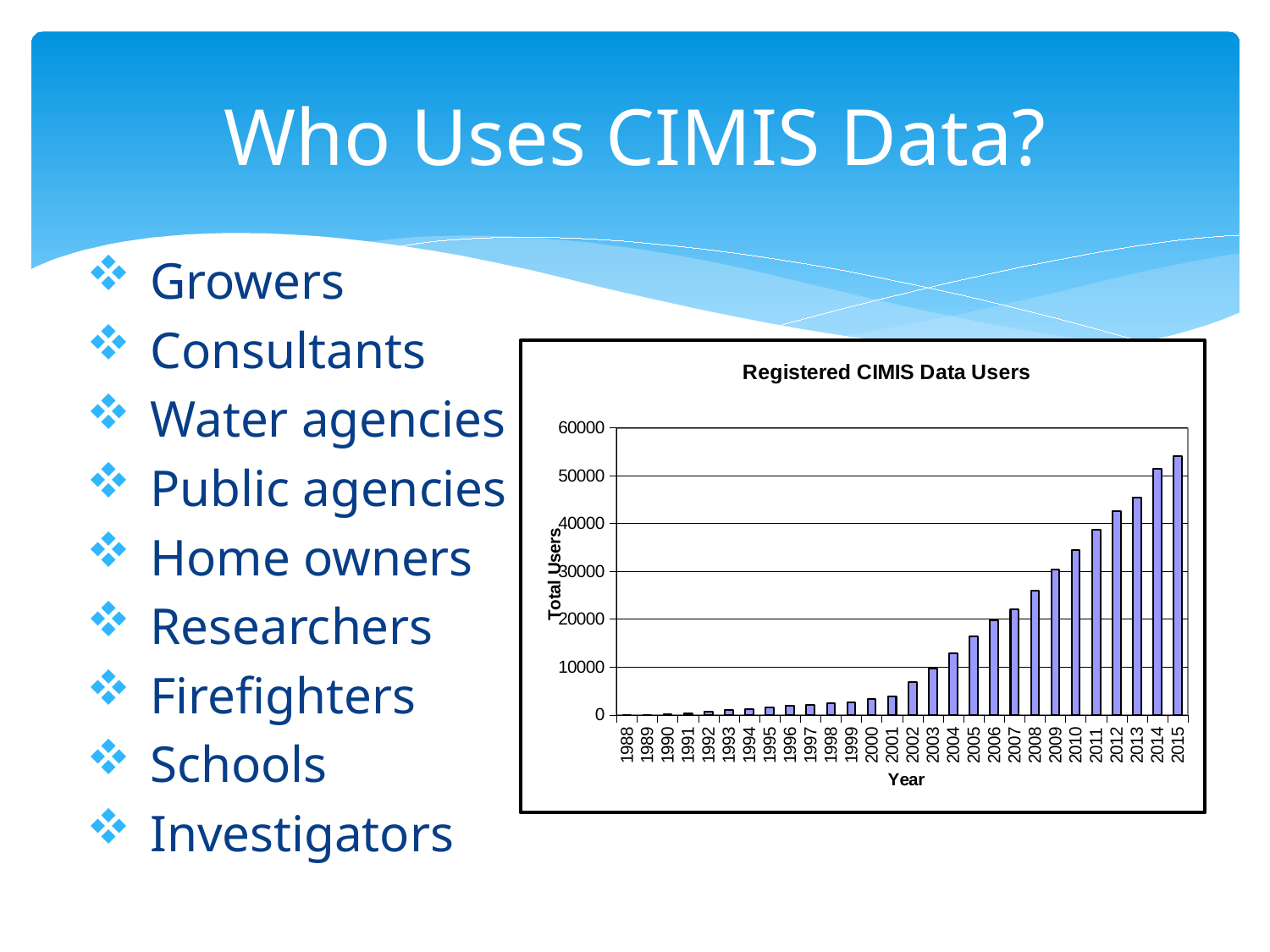
Is the value for 2011 greater or less than 40000? less Is the value for 2008 greater or less than 20000? greater Is the value for 2013 greater or less than 50000? less Do the total users generally rise or fall from 1988 to 2015? rise How many years are plotted on the x axis of the chart? 28 Which year has the highest number of total users? 2015 What type of chart is shown on the slide? bar chart What is the title of the chart? Registered CIMIS Data Users Which year has more total users, 2010 or 2015? 2015